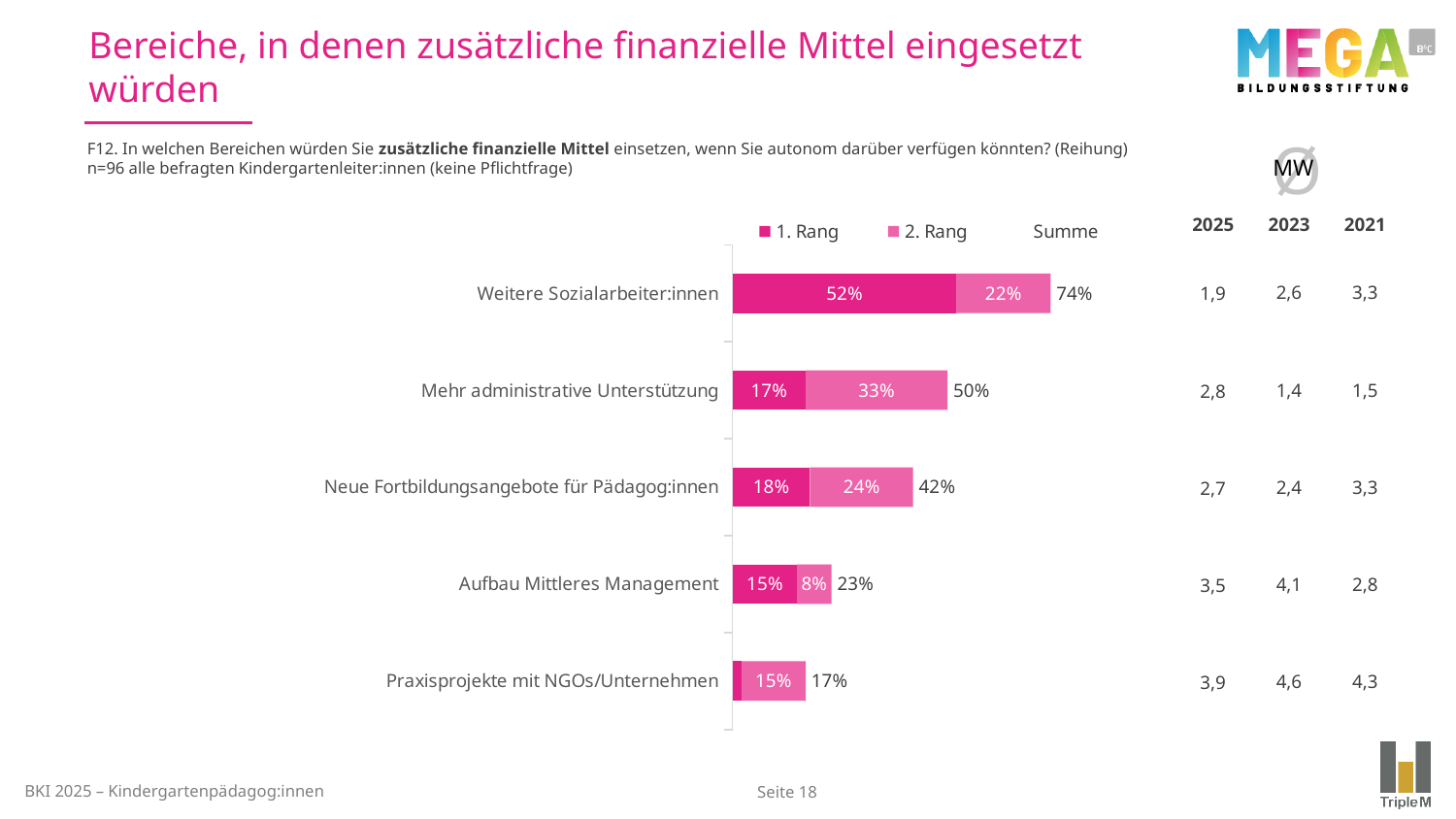
Which is larger: the 1. Rang value for Neue Fortbildungsangebote für Pädagog:innen or the 1. Rang value for Mehr administrative Unterstützung? Neue Fortbildungsangebote für Pädagog:innen What is the Summe value for Neue Fortbildungsangebote für Pädagog:innen? 42% What is the 2. Rang value for Mehr administrative Unterstützung? 33% Which category has the highest Summe value? Weitere Sozialarbeiter:innen How many categories are shown in the chart? 5 What is the difference between the Summe values for Weitere Sozialarbeiter:innen and Mehr administrative Unterstützung? 24% What kind of chart is shown on the slide? Stacked bar chart What is the 1. Rang value for Weitere Sozialarbeiter:innen? 52% What is the 2. Rang value for Aufbau Mittleres Management? 8% Which category has the lowest Summe value? Praxisprojekte mit NGOs/Unternehmen How many series does the chart legend list? 3